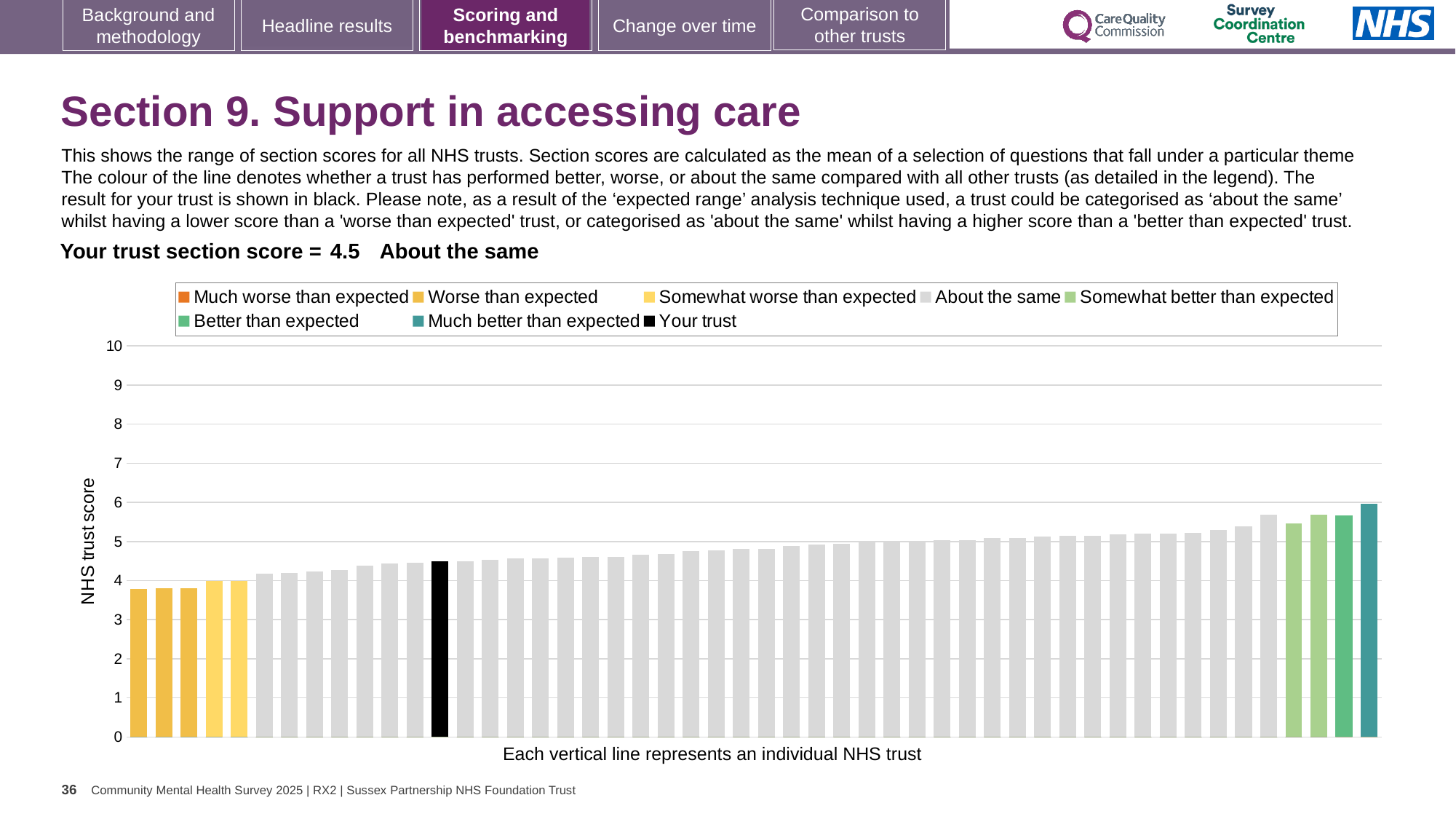
Is the value of the tallest bar (Much better than expected) greater or less than 5? greater What colour is used for the 'Your trust' bar? black How many entries does the chart legend list? 8 What kind of chart is shown on the slide? bar chart What is the section score for your trust? 4.5 How many bars are coloured as 'Worse than expected'? 3 Is the value of the black 'Your trust' bar greater or less than 4? greater What is the label on the y axis? NHS trust score Is the value of the leftmost bar greater or less than 4? less Which performance category is your trust placed in for this section? About the same Do the bar values rise or fall from left to right along the x axis? rise Which legend category does the tallest bar belong to? Much better than expected